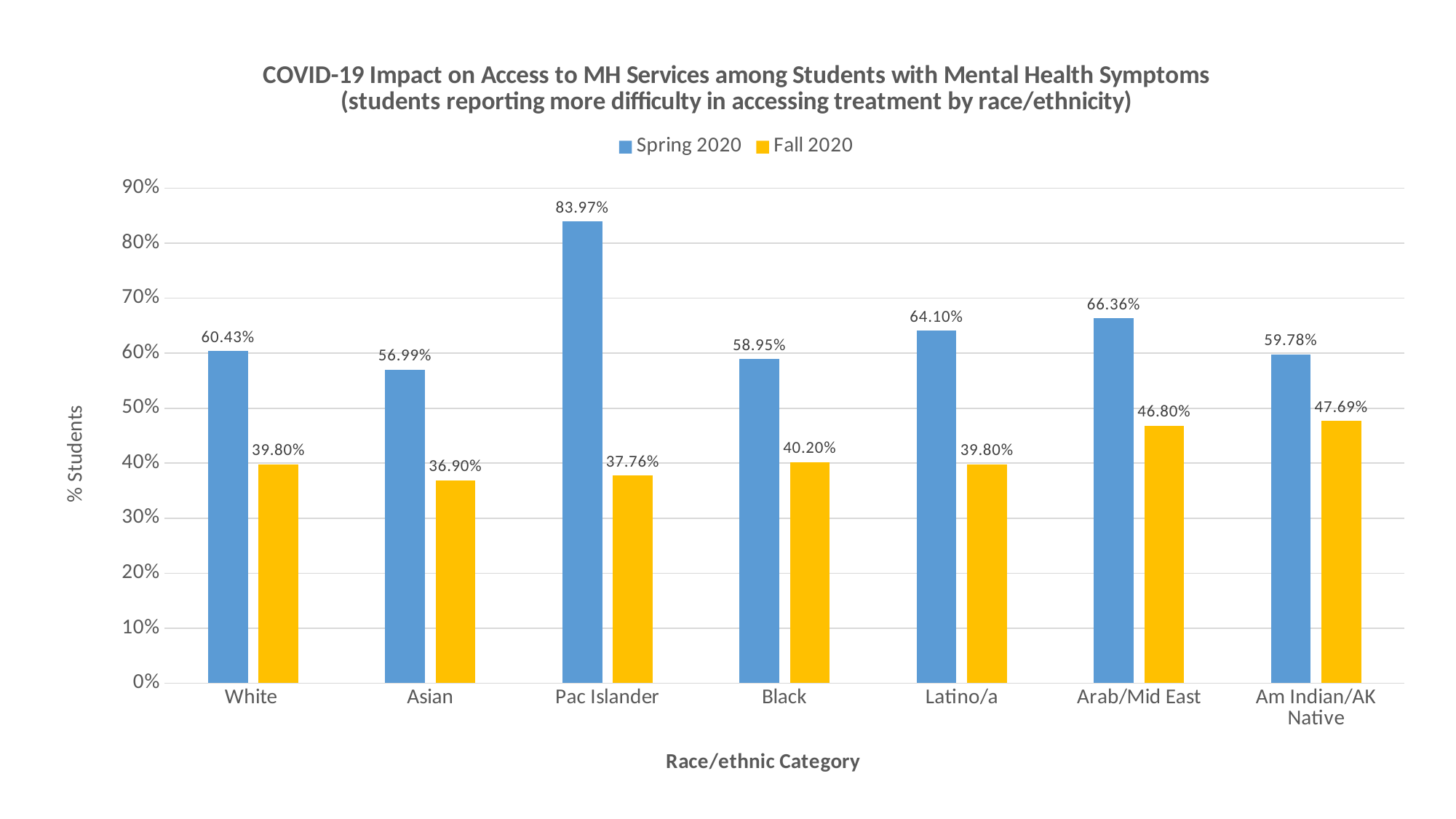
Which is larger, the Fall 2020 value for Am Indian/AK Native or the Fall 2020 value for Arab/Mid East? Am Indian/AK Native Which race/ethnic category has the highest Spring 2020 value? Pac Islander What is the Spring 2020 value for Pac Islander? 83.97% What is the label of the y axis? % Students Which race/ethnic category has the lowest Fall 2020 value? Asian How many race/ethnic categories are shown on the x axis? 7 What kind of chart is shown on the slide? Bar chart How many series does the legend list? 2 Is the Spring 2020 value for Latino/a greater or less than 60%? greater What is the Fall 2020 value for Asian? 36.90% What is the Fall 2020 value for Arab/Mid East? 46.80% What is the difference between the Spring 2020 and Fall 2020 values for Black? 18.75%